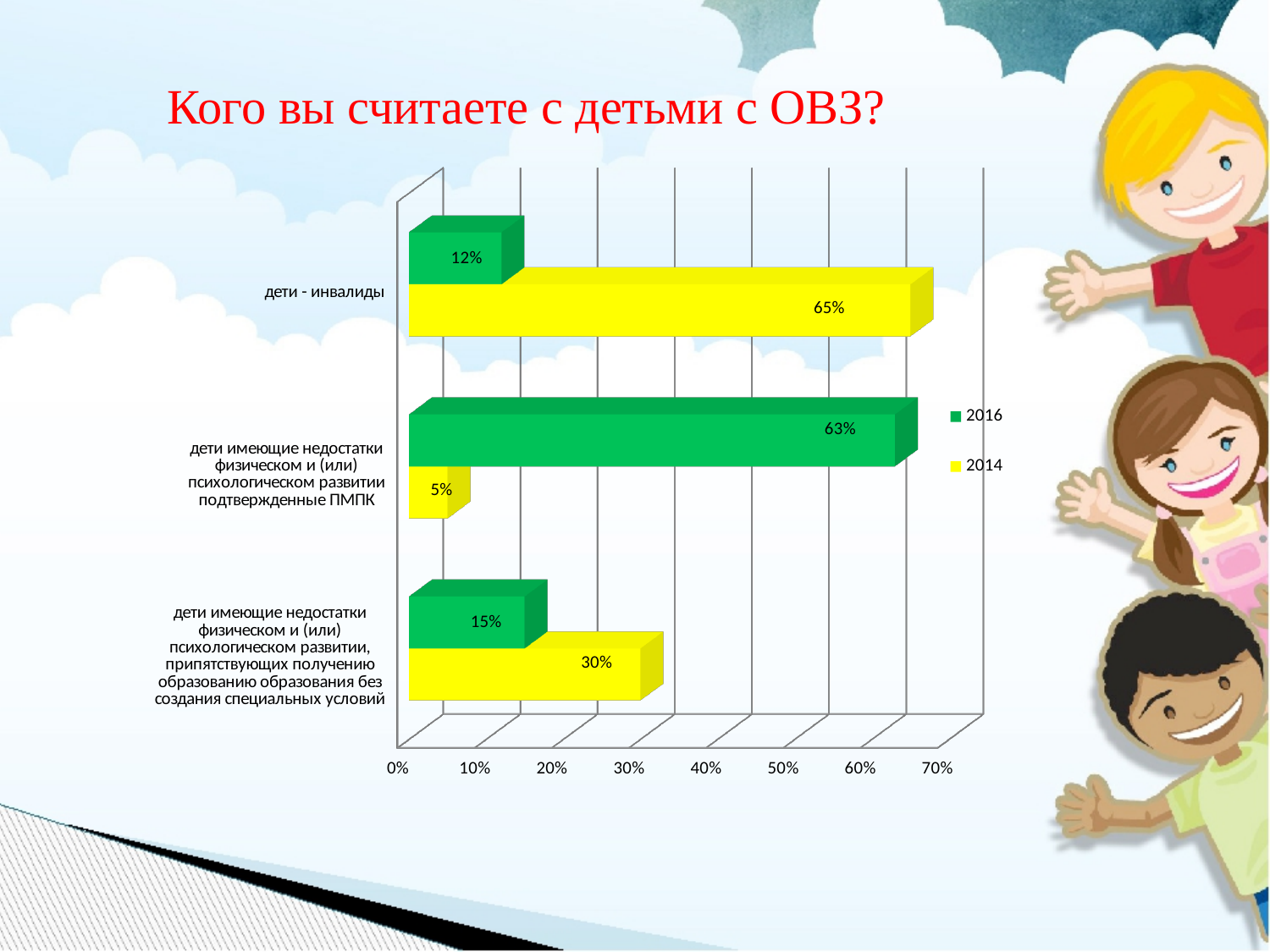
Which category has the highest 2016 value? дети имеющие недостатки физическом и (или) психологическом развитии подтвержденные ПМПК What kind of chart is shown on the slide? bar chart What is the 2016 value for "дети имеющие недостатки физическом и (или) психологическом развитии подтвержденные ПМПК"? 63% What is the difference between the 2014 and 2016 values for "дети - инвалиды"? 53% What is the 2014 value for "дети имеющие недостатки физическом и (или) психологическом развитии подтвержденные ПМПК"? 5% What is the 2016 value for "дети - инвалиды"? 12% What is the 2014 value for "дети - инвалиды"? 65% Which series is shown in yellow in the legend? 2014 How many categories are shown on the chart? 3 How many series does the legend list? 2 Which category has the lowest 2014 value? дети имеющие недостатки физическом и (или) психологическом развитии подтвержденные ПМПК What is the 2014 value for the category about children needing special conditions for education ("...без создания специальных условий")? 30%